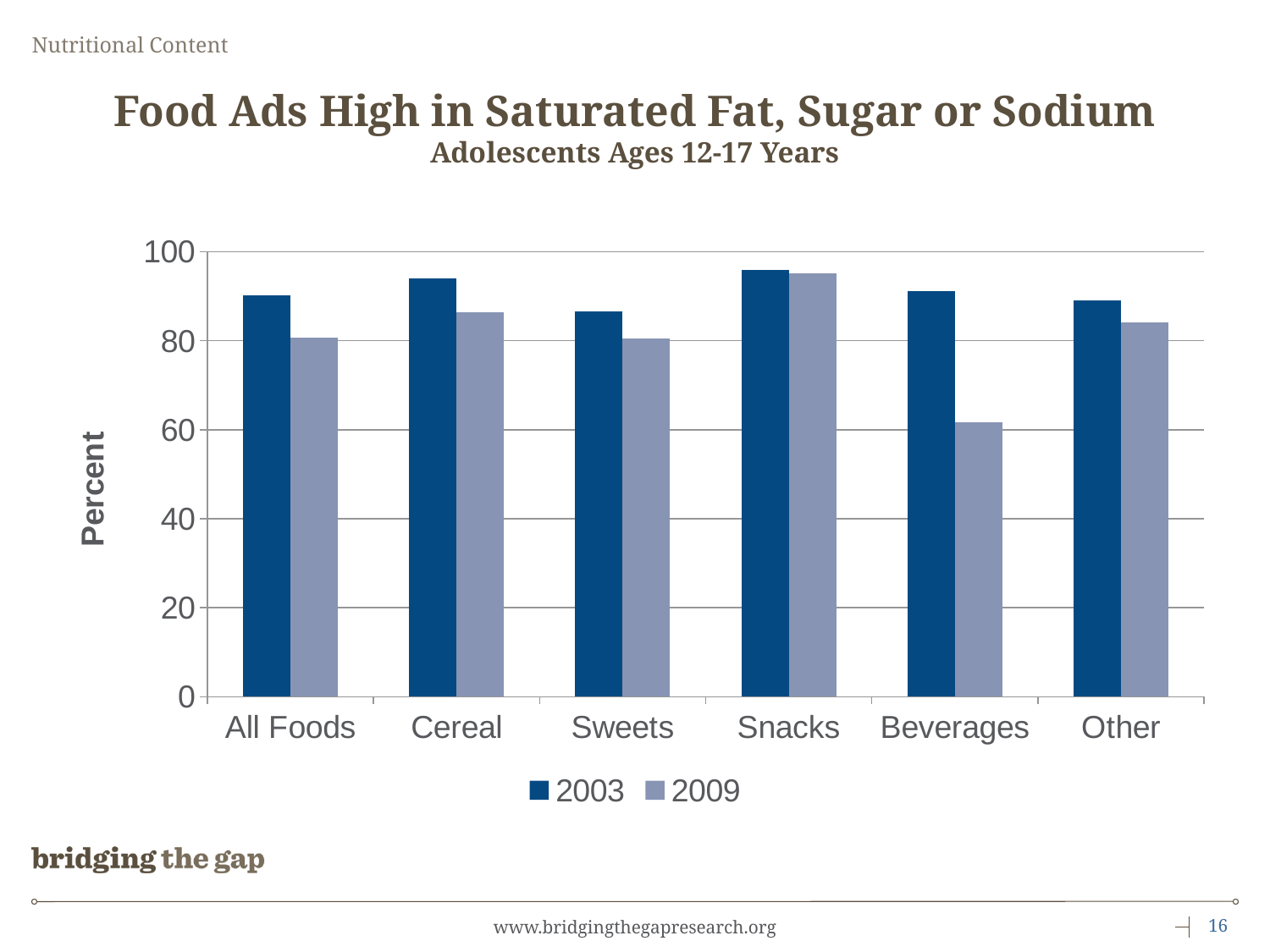
Which category has the highest value for 2003? Snacks Which is larger for 2009, Snacks or Beverages? Snacks Is the 2009 value for Beverages greater or less than 80? less Which category has the highest value for 2009? Snacks How many series does the legend list? 2 Is the 2003 value for Snacks greater or less than 80? greater How many food categories are shown on the x axis? 6 What is the label on the y axis? Percent What kind of chart is shown on the slide? Bar chart For Beverages, which year has the larger value, 2003 or 2009? 2003 Which category has the lowest value for 2009? Beverages